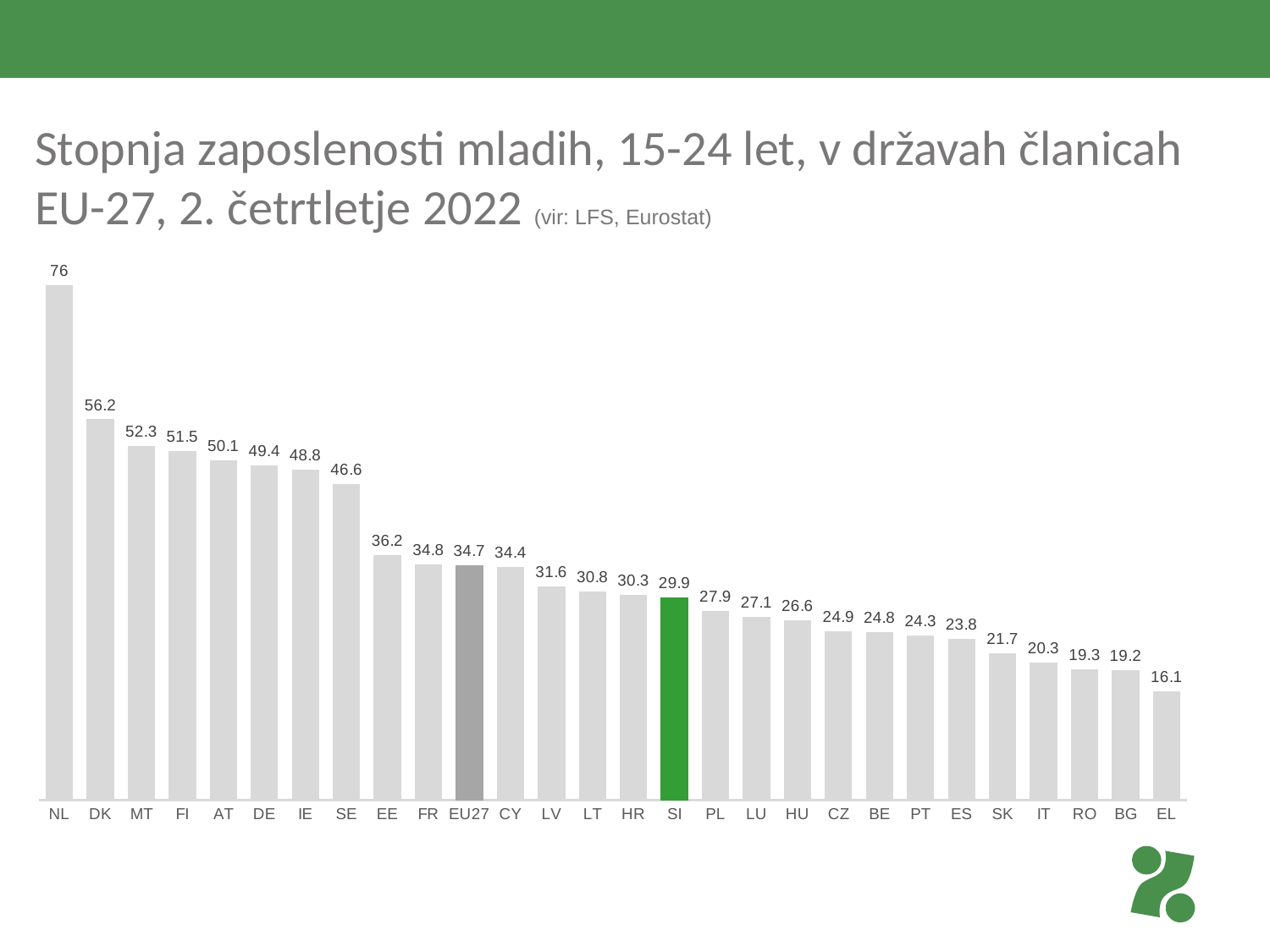
What kind of chart is shown on the slide? Bar chart What is the difference between the values for NL and DK? 19.8 What is the value for NL? 76 Which country has the highest value? NL Which country has the lowest value? EL What is the value for SI? 29.9 Do the values rise or fall from left to right along the x axis? Fall What is the value for EU27? 34.7 How many bars are shown in the chart? 28 Which bar is coloured green? SI What is the difference between the values for EU27 and SI? 4.8 Which has a larger value, SE or EE? SE